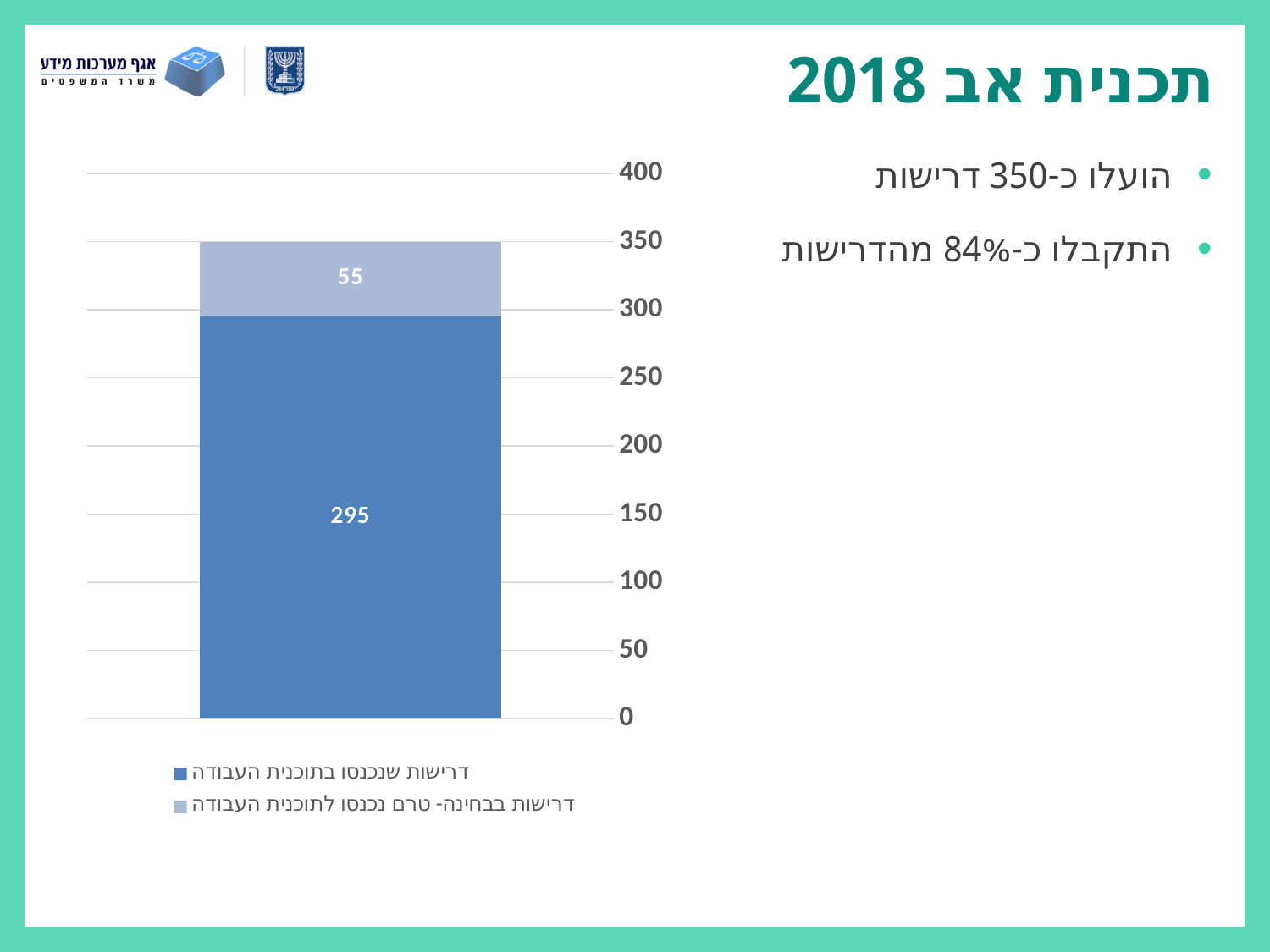
How many bars are plotted in the chart? 1 Is the value for "דרישות בבחינה- טרם נכנסו לתוכנית העבודה" greater or less than 100? less How many series does the chart legend list? 2 What is the maximum value shown on the chart's vertical axis? 400 Which series has the larger value, "דרישות שנכנסו בתוכנית העבודה" or "דרישות בבחינה- טרם נכנסו לתוכנית העבודה"? דרישות שנכנסו בתוכנית העבודה Is the total height of the stacked bar greater or less than 300? greater What is the total of the stacked bar? 350 Which legend entry is shown in the darker blue colour? דרישות שנכנסו בתוכנית העבודה What type of chart is shown on the slide? Stacked bar chart What is the value of the series "דרישות שנכנסו בתוכנית העבודה"? 295 What is the value of the series "דרישות בבחינה- טרם נכנסו לתוכנית העבודה"? 55 What is the difference between the two segments of the stacked bar (295 and 55)? 240